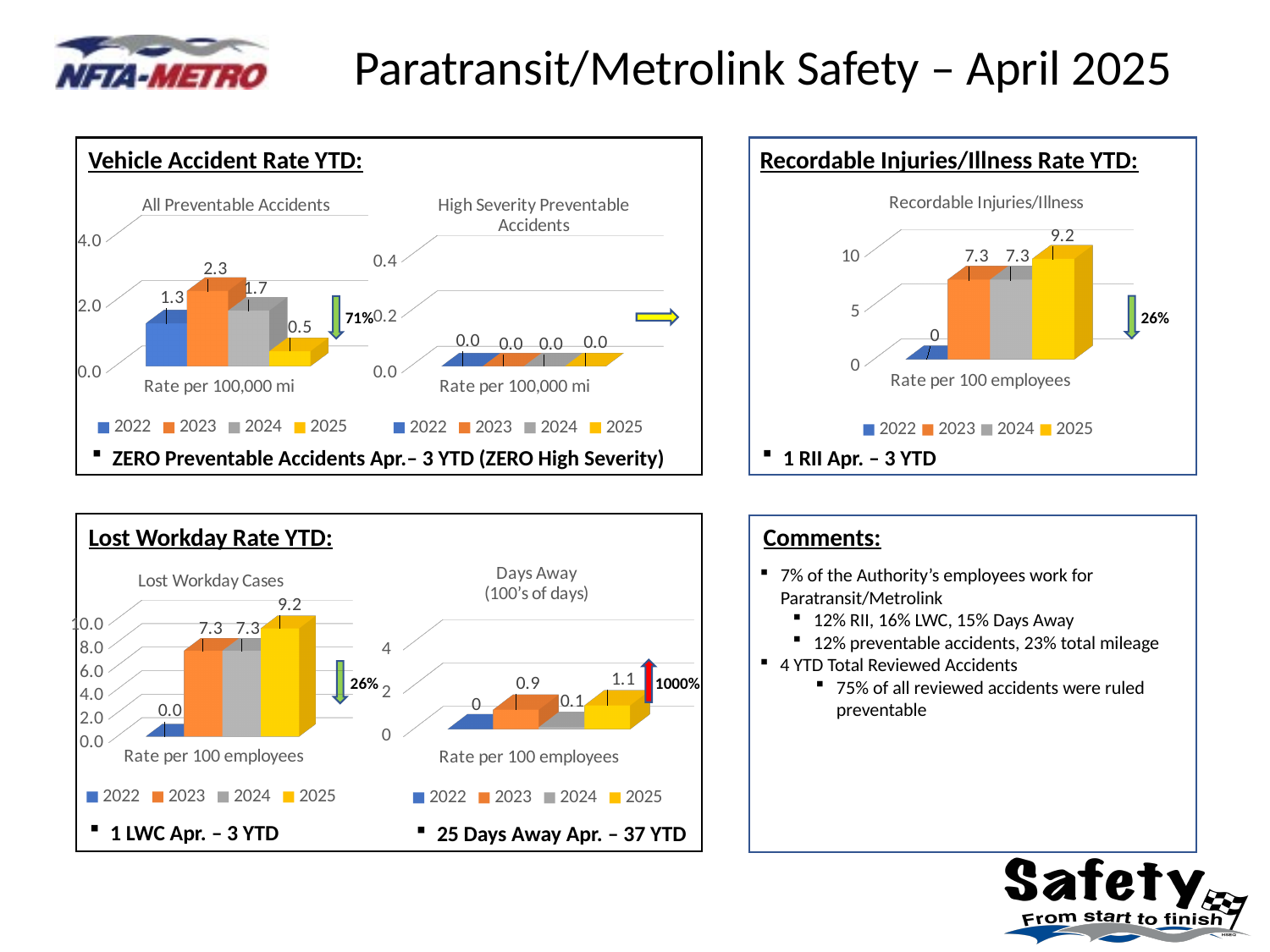
In the "Days Away (100's of days)" chart, what is the value for 2024? 0.1 In the "Recordable Injuries/Illness" chart, what is the value for 2022? 0 In the "Lost Workday Cases" chart, is the value for 2023 larger or smaller than the value for 2025? smaller What kind of chart is the "Lost Workday Cases" chart? bar chart In the "Lost Workday Cases" chart, what is the value for 2025? 9.2 In the "All Preventable Accidents" chart, which year has the lowest value? 2025 How many series does the legend of the "Recordable Injuries/Illness" chart list? 4 In the "All Preventable Accidents" chart, what is the difference between the 2023 and 2025 values? 1.8 In the "Days Away (100's of days)" chart, what is the difference between the 2025 and 2023 values? 0.2 In the "All Preventable Accidents" chart, what is the value for 2023? 2.3 In the "High Severity Preventable Accidents" chart, what is the value for 2024? 0.0 In the "Recordable Injuries/Illness" chart, which year has the highest value? 2025